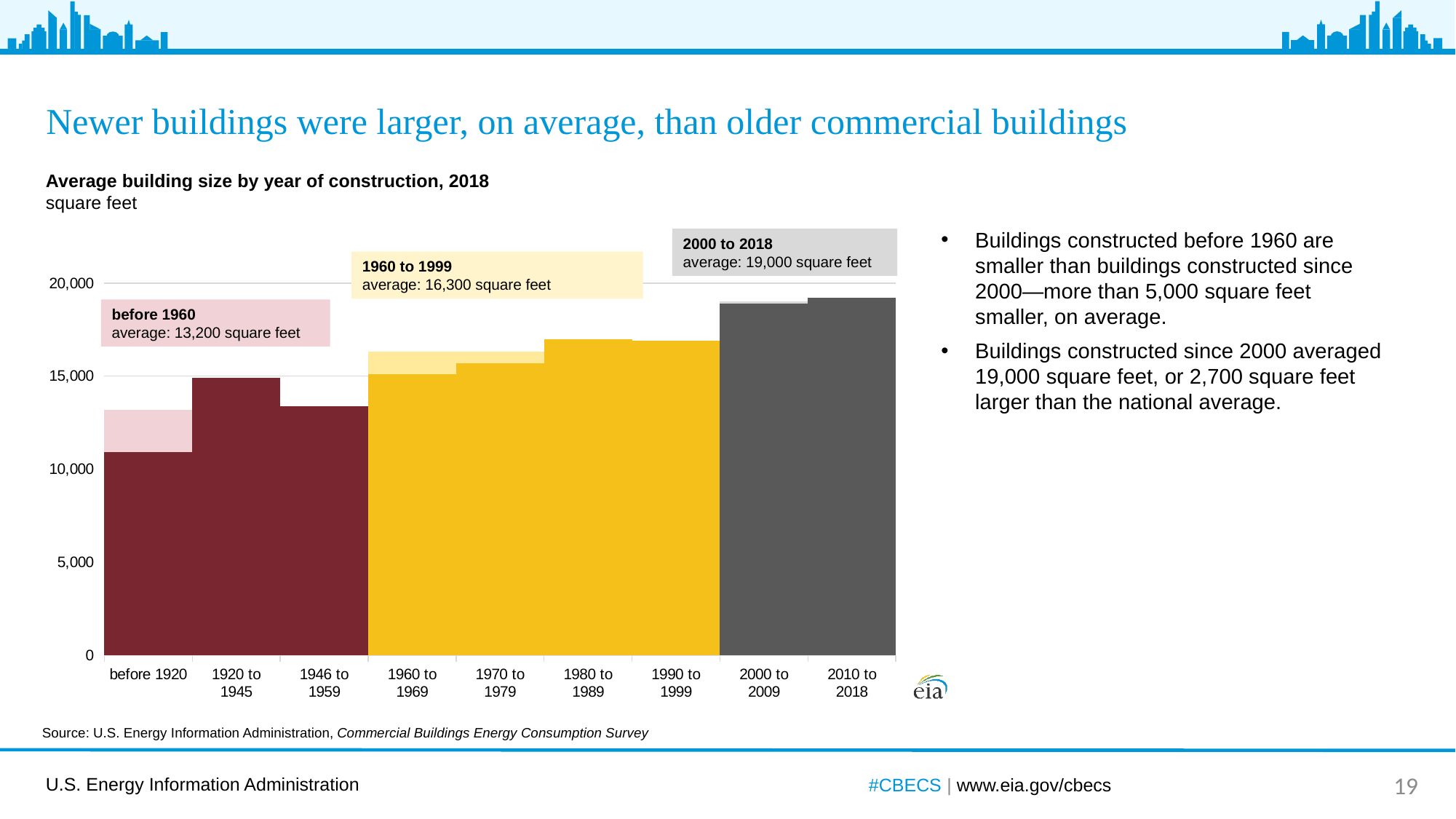
Is the value for 1980 to 1989 greater or less than 15,000? greater How much larger is the printed average for 2000 to 2018 than the printed average for before 1960? 5,800 square feet What is the average building size for buildings constructed before 1960, as printed on the chart? 13,200 square feet How much larger is the printed average for 1960 to 1999 than the printed average for before 1960? 3,100 square feet How many construction-period categories are shown on the x axis? 9 What is the average building size for buildings constructed from 2000 to 2018, as printed on the chart? 19,000 square feet What kind of chart is shown on the slide? bar chart Which is larger, the value for before 1920 or the value for 2010 to 2018? 2010 to 2018 What is the average building size for buildings constructed from 1960 to 1999, as printed on the chart? 16,300 square feet Is the value for 2000 to 2009 greater or less than 15,000? greater Is the value for before 1920 greater or less than 15,000? less Which construction period has the lowest average building size? before 1920